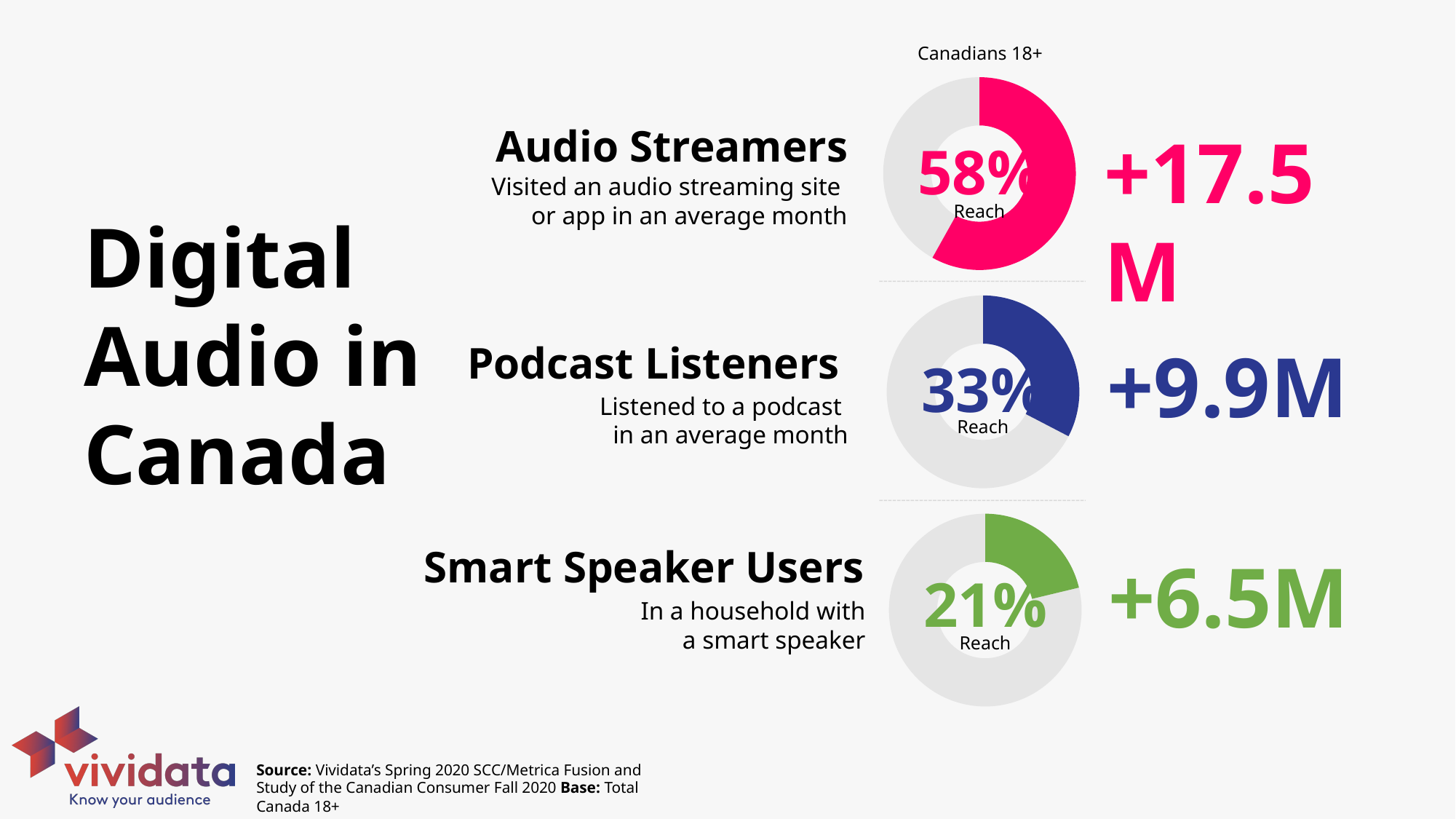
What is the difference in reach percentage between Audio Streamers and Podcast Listeners? 25% How many Canadians 18+ are Smart Speaker Users, according to the figure next to the bottom donut chart? +6.5M What type of chart is used to show the reach percentages on the slide? Donut (pie) chart How many Canadians 18+ are Audio Streamers, according to the figure next to the top donut chart? +17.5M What is the reach percentage shown in the Smart Speaker Users donut chart? 21% Which of the three groups has the lowest reach percentage? Smart Speaker Users What is the reach percentage shown in the Podcast Listeners donut chart? 33% Which has a higher reach: Podcast Listeners or Smart Speaker Users? Podcast Listeners How many Canadians 18+ are Podcast Listeners, according to the figure next to the middle donut chart? +9.9M Which of the three groups has the highest reach percentage? Audio Streamers What colour is the filled segment of the Podcast Listeners donut chart? Blue What is the reach percentage shown in the Audio Streamers donut chart? 58%